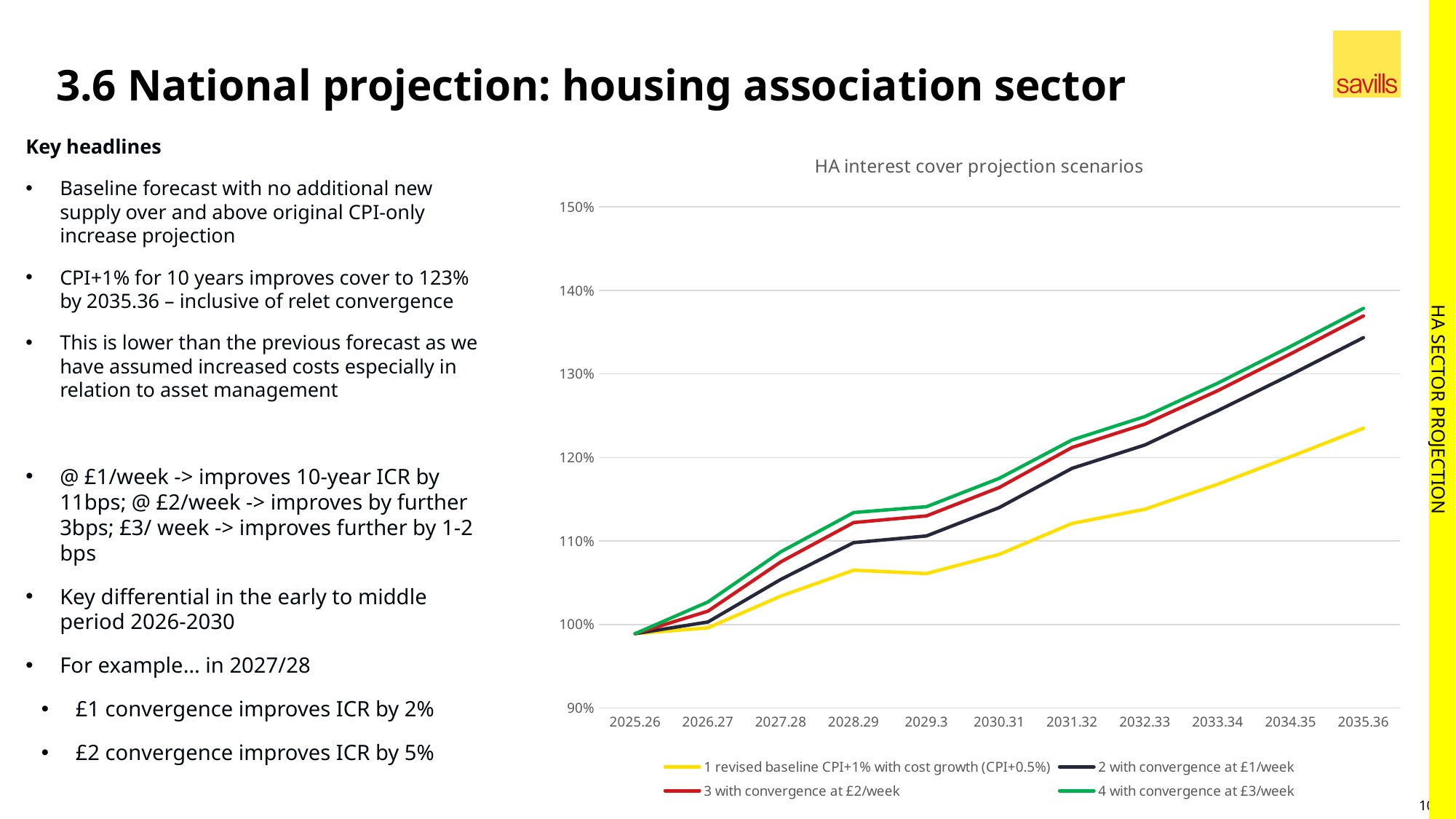
Is the value for '4 with convergence at £3/week' at 2035.36 greater or less than 130%? greater Which series has the lowest value at 2035.36? 1 revised baseline CPI+1% with cost growth (CPI+0.5%) How many years are shown along the x axis of the chart? 11 What colour is the line for '3 with convergence at £2/week'? red At 2030.31, which is higher: '4 with convergence at £3/week' or '1 revised baseline CPI+1% with cost growth (CPI+0.5%)'? 4 with convergence at £3/week Which series has the highest value at 2035.36? 4 with convergence at £3/week Is the value for '1 revised baseline CPI+1% with cost growth (CPI+0.5%)' at 2028.29 greater or less than 110%? less What kind of chart is shown on the slide? line chart How many series does the chart's legend list? 4 Is the value for '1 revised baseline CPI+1% with cost growth (CPI+0.5%)' at 2035.36 greater or less than 120%? greater Do the values of the '4 with convergence at £3/week' series rise or fall from 2025.26 to 2035.36? rise What is the title of the chart? HA interest cover projection scenarios